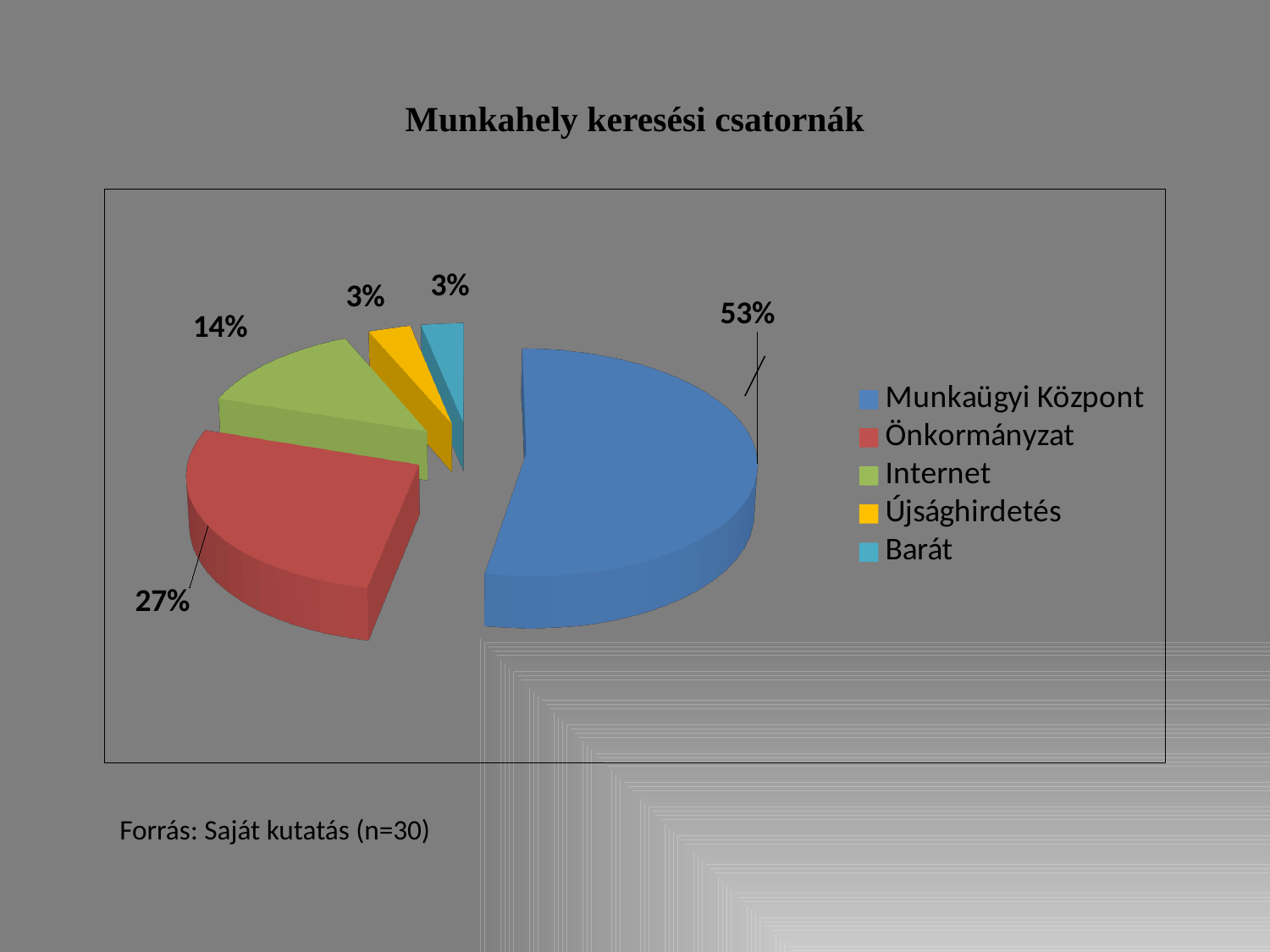
What is the difference in percentage points between Munkaügyi Központ and Önkormányzat? 26 Which is larger, the share for Önkormányzat or the share for Internet? Önkormányzat How many categories does the legend list? 5 Which category has the largest slice of the pie? Munkaügyi Központ What share of the pie does Önkormányzat have? 27% What share of the pie does Munkaügyi Központ have? 53% What share of the pie does Újsághirdetés have? 3% What type of chart is shown on the slide? Pie chart What is the difference in percentage points between Internet and Barát? 11 What is the title of the chart? Munkahely keresési csatornák Which colour represents Internet in the chart? Green